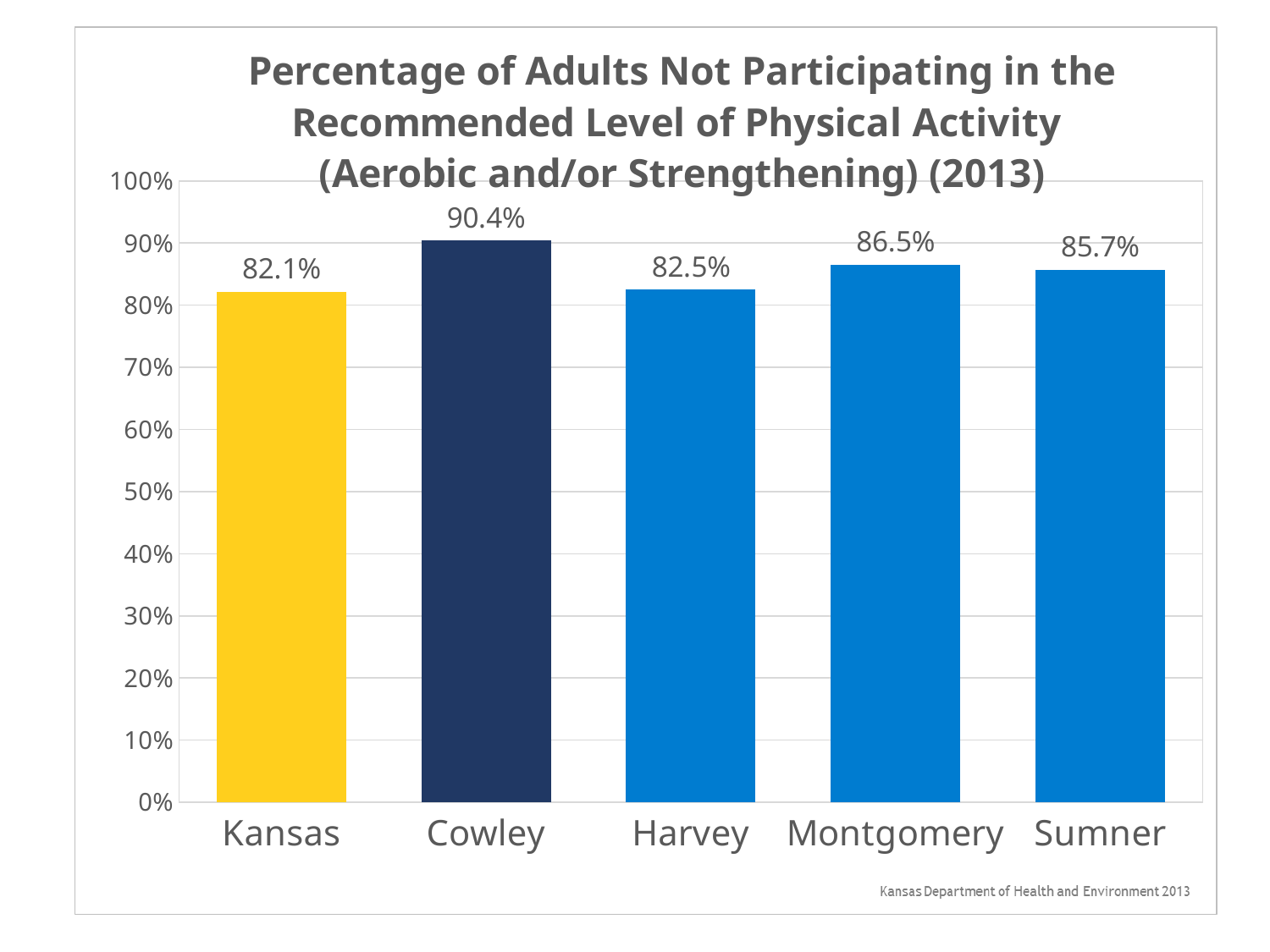
How many categories are shown on the x axis? 5 What is the value for Montgomery? 86.5% Is the value for Cowley greater or less than 90%? greater Which category has the lowest value? Kansas Which category has the highest value? Cowley Which is larger, the value for Harvey or the value for Sumner? Sumner What kind of chart is shown on the slide? bar chart What is the difference between the values for Cowley and Kansas? 8.3% What is the source cited at the bottom of the chart? Kansas Department of Health and Environment 2013 What is the value for Cowley? 90.4% What is the value for Kansas? 82.1% What is the difference between the values for Montgomery and Sumner? 0.8%